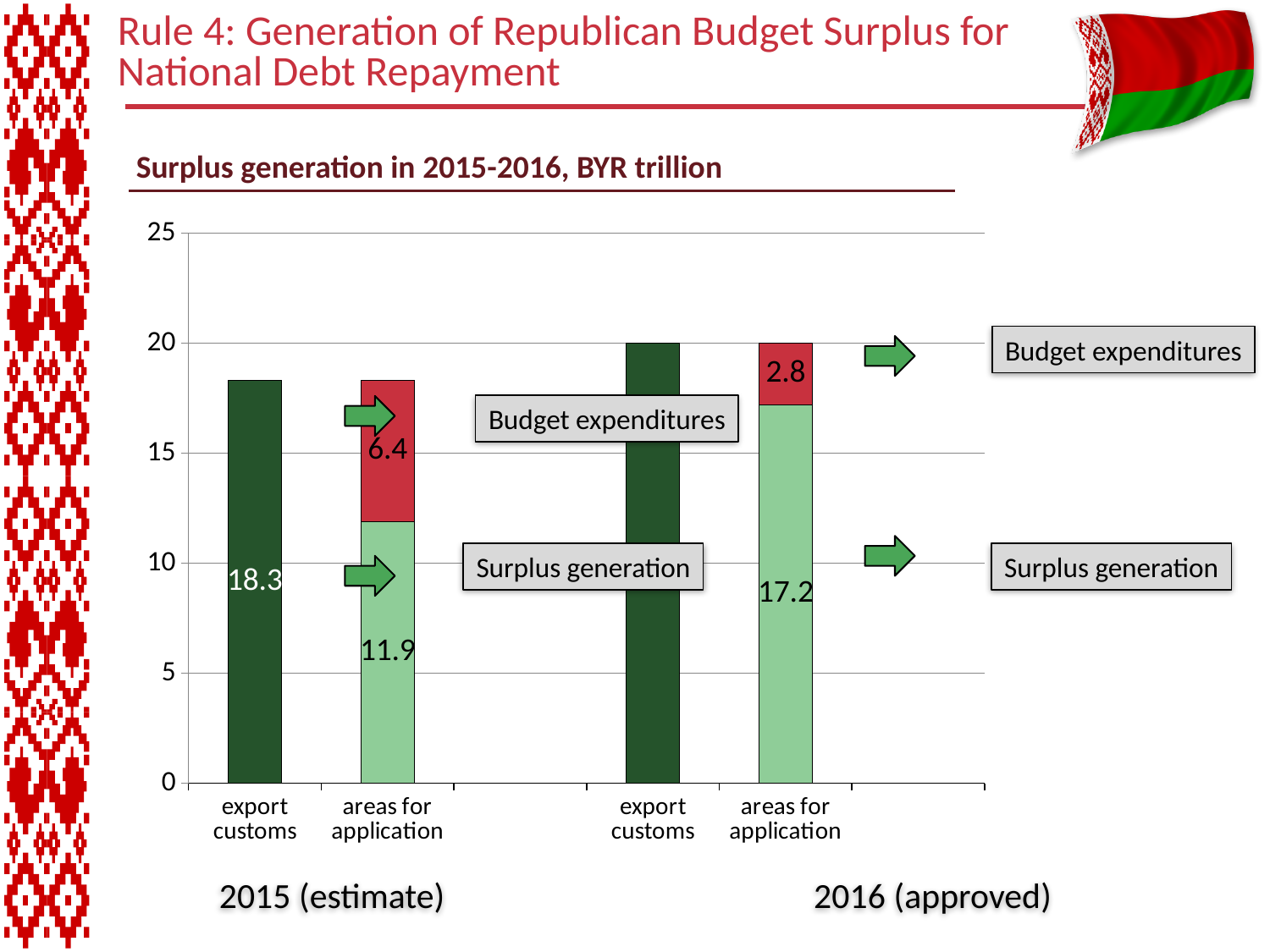
What is the total of the stacked areas for application bar for 2016 (approved)? 20.0 What is the budget expenditures value in the 2015 (estimate) areas for application bar? 6.4 How much larger is surplus generation in 2016 (approved) than in 2015 (estimate)? 5.3 Which year has the larger surplus generation value, 2015 (estimate) or 2016 (approved)? 2016 (approved) What is the total of the stacked areas for application bar for 2015 (estimate)? 18.3 What is the surplus generation value in the 2016 (approved) areas for application bar? 17.2 What kind of chart is shown on the slide? bar chart What is the budget expenditures value in the 2016 (approved) areas for application bar? 2.8 What is the difference between budget expenditures in 2015 (estimate) and 2016 (approved)? 3.6 What is the surplus generation value in the 2015 (estimate) areas for application bar? 11.9 Is the value for export customs in 2016 (approved) greater or less than 15? greater What is the value for export customs in 2015 (estimate)? 18.3